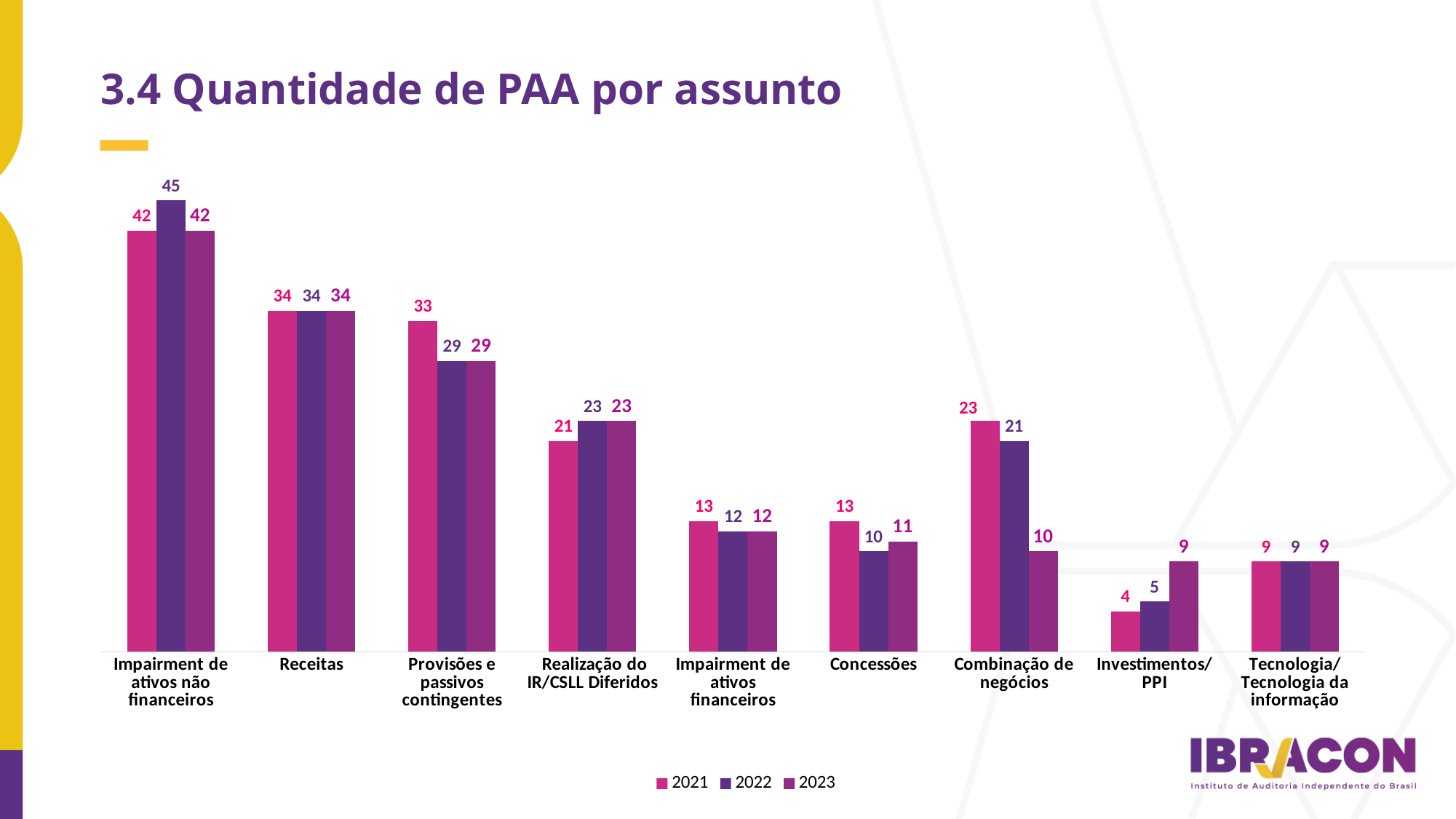
How many categories are shown on the x axis? 9 What kind of chart is shown on the slide? Bar chart Which category has the highest value in 2022? Impairment de ativos não financeiros How many series does the legend list? 3 Which category has the lowest value in 2021? Investimentos/PPI What is the value for Receitas in 2022? 34 Which is larger for Provisões e passivos contingentes: the 2021 value or the 2022 value? 2021 What is the value for Combinação de negócios in 2023? 10 What is the difference between the 2021 and 2023 values for Combinação de negócios? 13 What is the value for Investimentos/PPI in 2021? 4 What is the title of the chart? 3.4 Quantidade de PAA por assunto